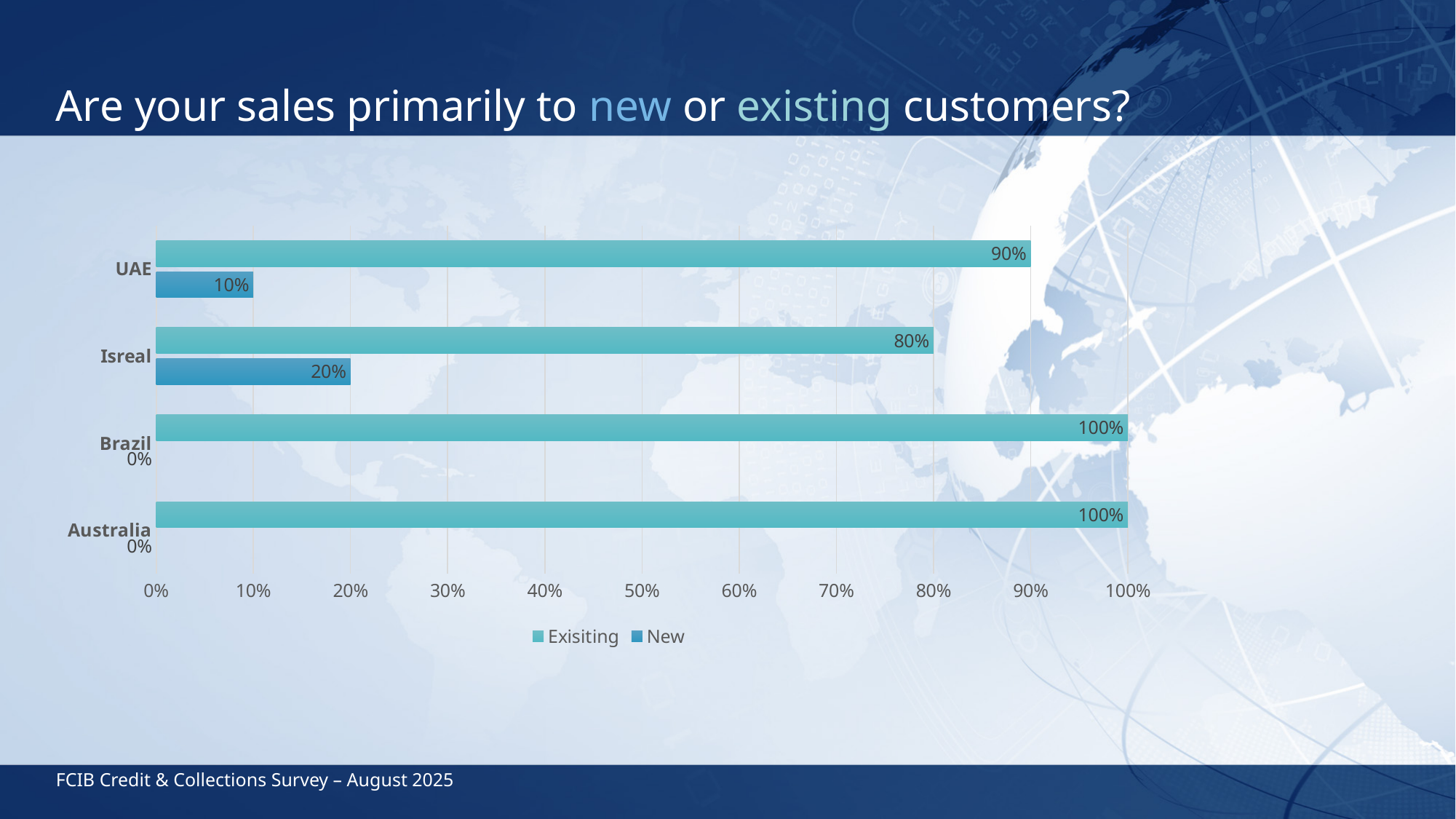
Which country has the highest value for New customers? Isreal How many countries are shown on the chart? 4 What are the two series named in the legend? Exisiting and New What is the value for New customers for Brazil? 0% Which country has the lowest value for Exisiting customers? Isreal What is the difference between the Exisiting and New values for UAE? 80% What is the value for New customers for Isreal? 20% What kind of chart is shown on the slide? Bar chart Which is larger for Isreal, the Exisiting value or the New value? Exisiting How many series does the legend list? 2 What is the Exisiting value for Australia? 100% What percentage of UAE respondents said their sales are primarily to existing customers? 90%